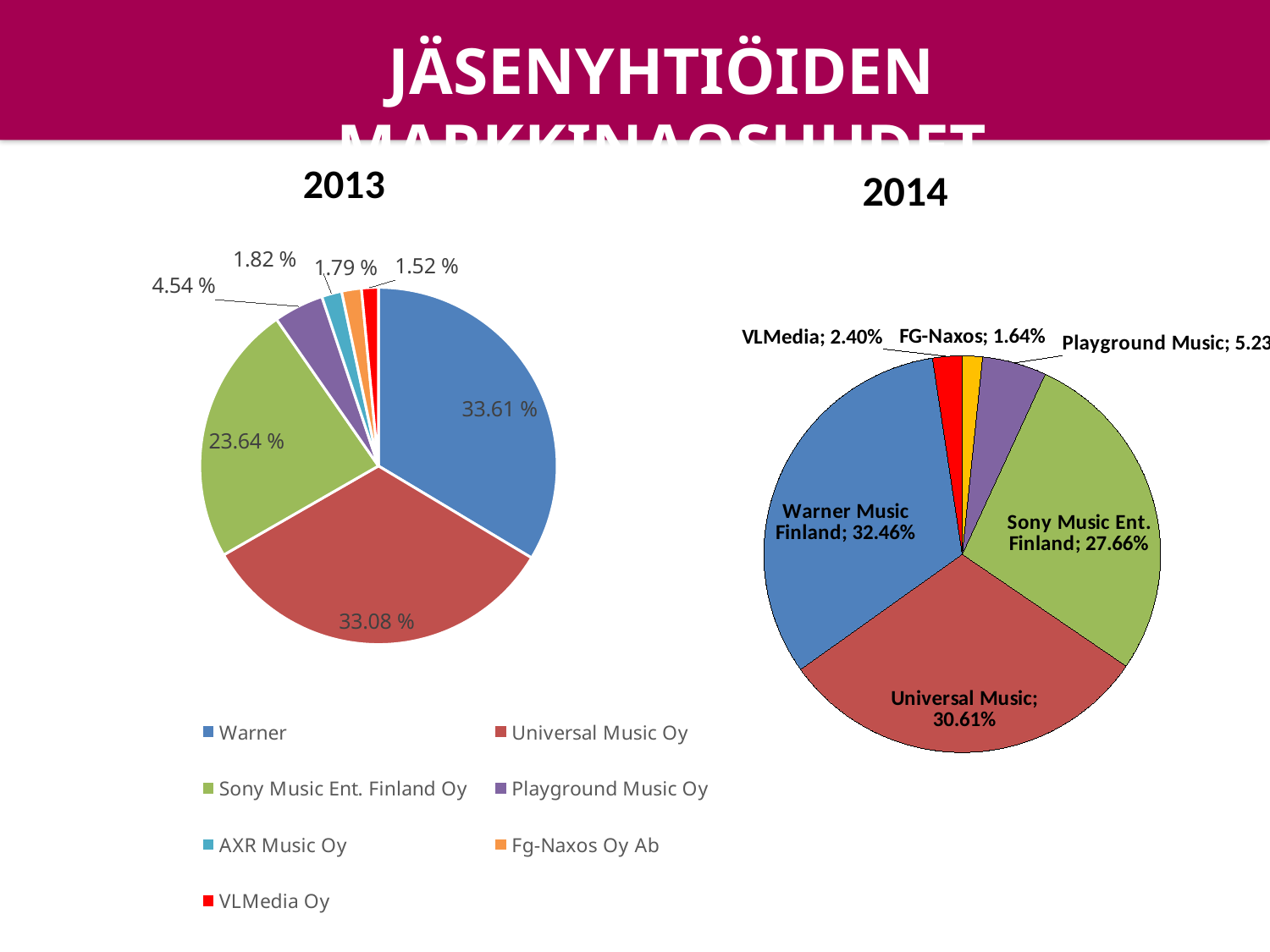
In the 2014 chart, which company has the smallest share? FG-Naxos In the 2014 chart, what share does FG-Naxos have? 1.64% In the 2014 chart, what share does Sony Music Ent. Finland have? 27.66% In the 2014 chart, what is the difference between the shares of Warner Music Finland and Universal Music? 1.85% In the 2014 chart, what share does Warner Music Finland have? 32.46% What kind of chart is the 2013 chart? pie chart In the 2014 chart, what share does Universal Music have? 30.61% How many entries does the legend of the 2013 chart list? 7 In the 2013 chart, what share does Sony Music Ent. Finland Oy have? 23.64 % In the 2014 chart, what share does VLMedia have? 2.40% In the 2013 chart, what is the largest share shown? 33.61 % In the 2014 chart, which company has the largest share? Warner Music Finland